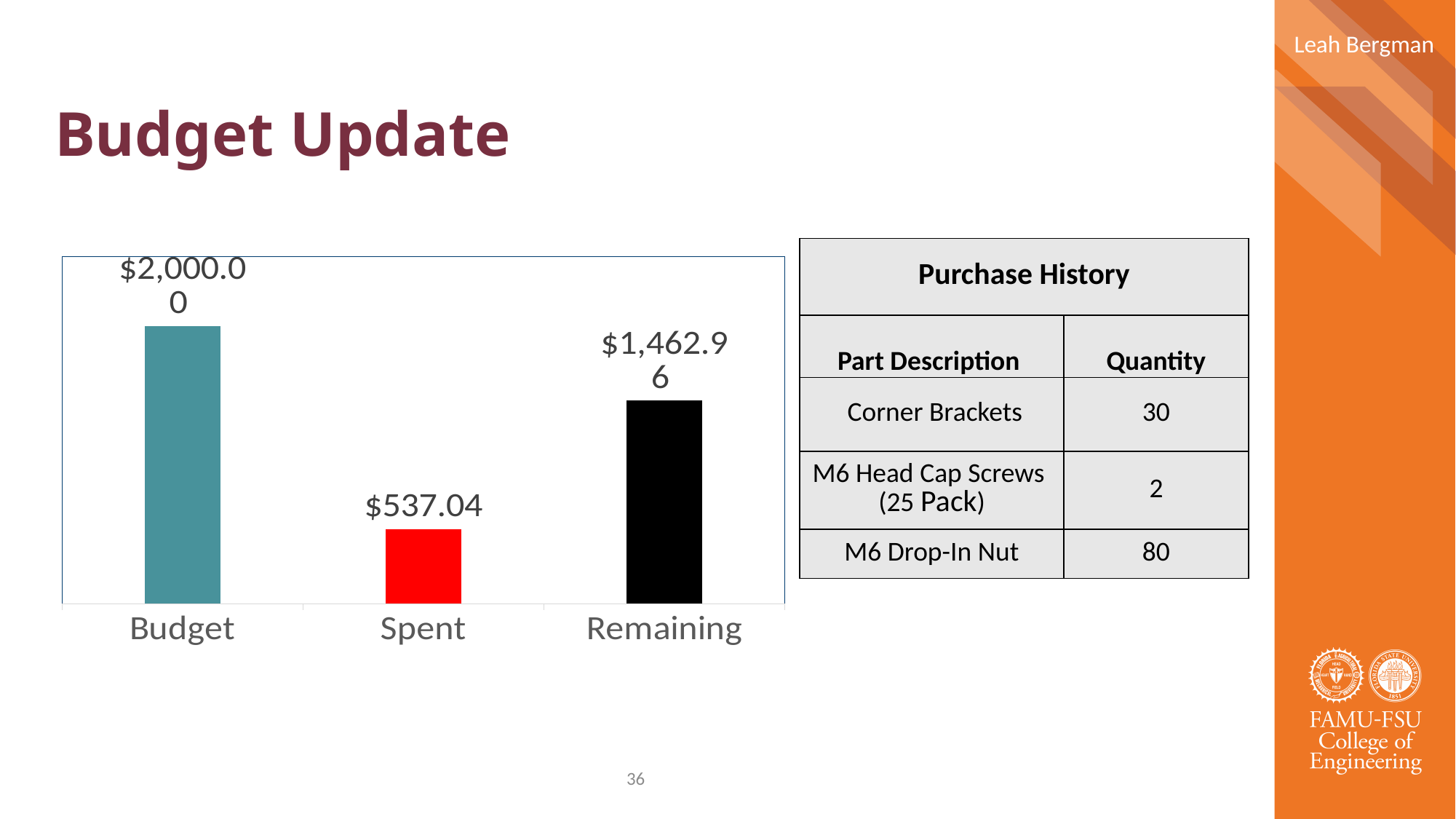
What colour is the Remaining bar in the chart? Black What is the difference between the Remaining and Spent values in the bar chart? $925.92 Which category has the lowest value in the bar chart? Spent Which category has the highest value in the bar chart? Budget What colour is the Spent bar in the chart? Red What is the value shown for Spent in the bar chart? $537.04 What is the value shown for Remaining in the bar chart? $1,462.96 How many categories are shown in the bar chart? 3 Which is larger in the bar chart, Spent or Remaining? Remaining What kind of chart is shown on the slide? Bar chart What is the value shown for Budget in the bar chart? $2,000.00 What is the difference between the Budget and Spent values in the bar chart? $1,462.96